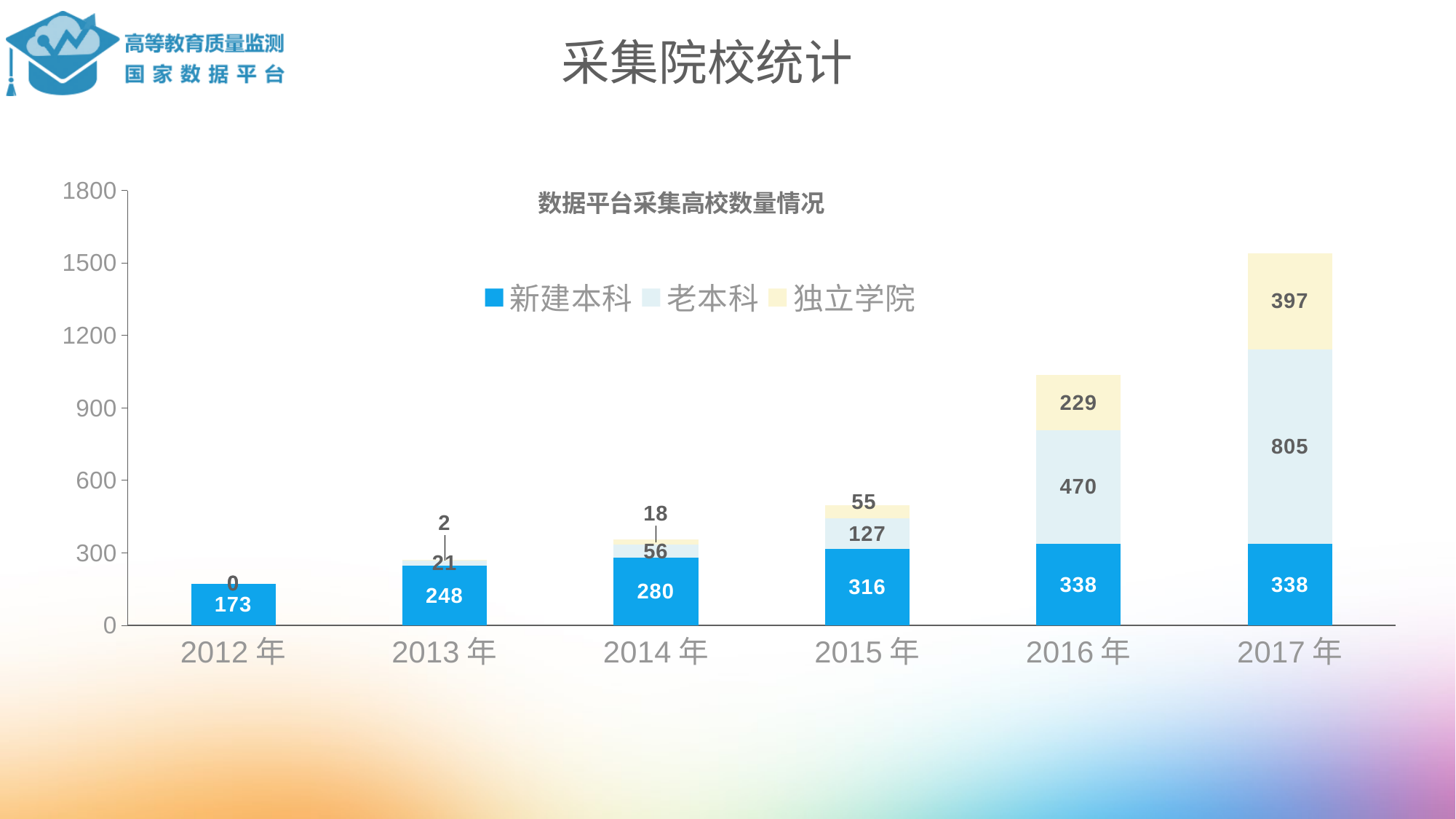
What is the title of the chart? 数据平台采集高校数量情况 What is the value for 新建本科 in 2014年? 280 How many series does the legend list? 3 What is the total of the stacked bar for 2016年? 1037 What is the value for 独立学院 in 2017年? 397 What is the difference between the 老本科 values for 2017年 and 2016年? 335 How many years are shown on the x axis? 6 Which year has the highest value for 老本科? 2017年 What kind of chart is shown on the slide? stacked bar chart Does the total for 老本科 rise or fall from 2013年 to 2017年? rise What is the value for 老本科 in 2016年? 470 What is the total of the stacked bar for 2017年? 1540